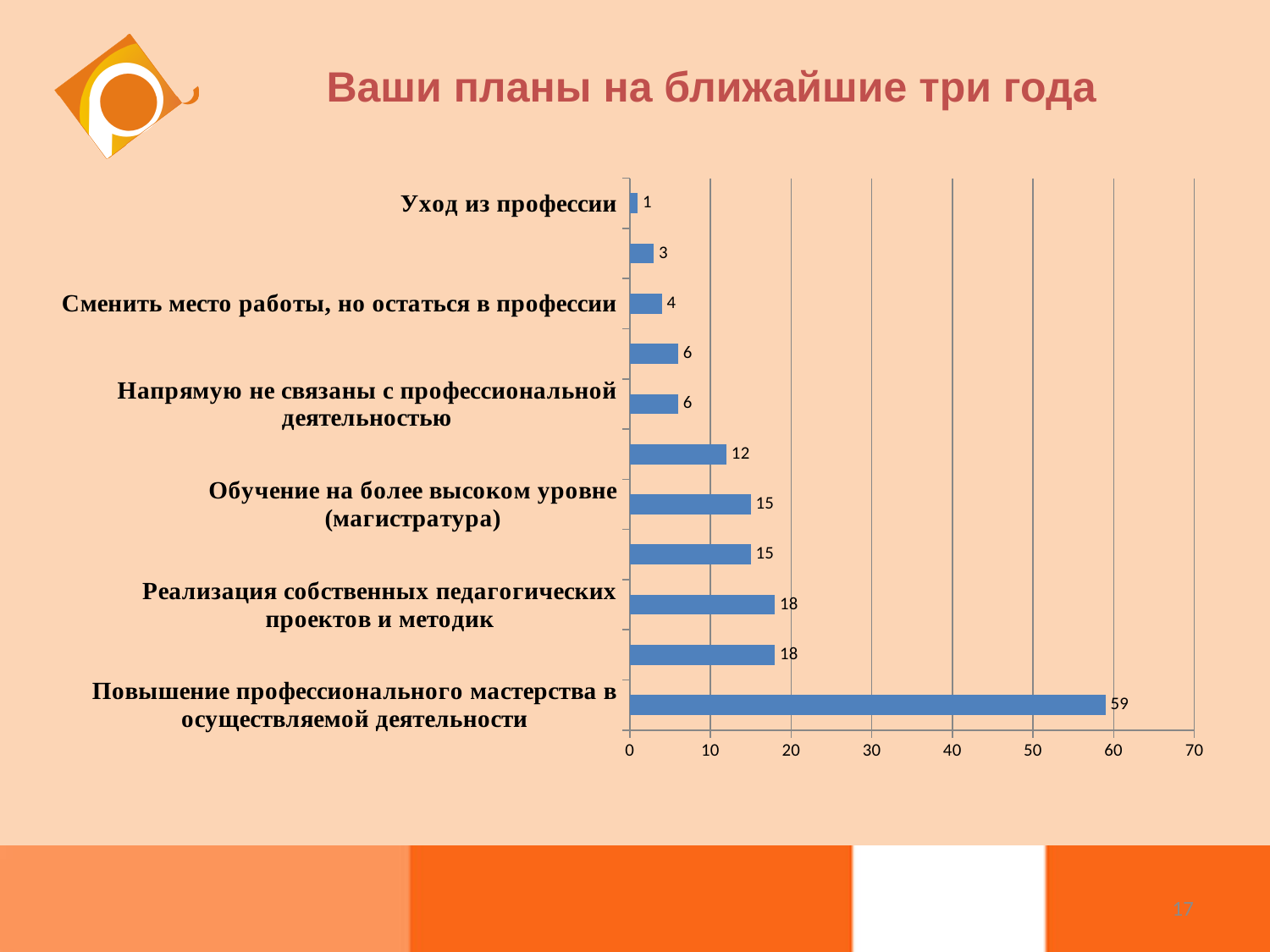
What is the value for "Уход из профессии"? 1 What is the title of the slide? Ваши планы на ближайшие три года What is the value for "Обучение на более высоком уровне (магистратура)"? 15 What is the value for "Сменить место работы, но остаться в профессии"? 4 How many bars are plotted in the chart? 11 Which category has the highest value? Повышение профессионального мастерства в осуществляемой деятельности What is the difference between the values for "Повышение профессионального мастерства в осуществляемой деятельности" and "Реализация собственных педагогических проектов и методик"? 41 Is the value for "Повышение профессионального мастерства в осуществляемой деятельности" greater or less than 50? greater What is the value for "Повышение профессионального мастерства в осуществляемой деятельности"? 59 What kind of chart is shown on the slide? bar chart Which category has the lowest value? Уход из профессии Which is larger: the value for "Напрямую не связаны с профессиональной деятельностью" or for "Сменить место работы, но остаться в профессии"? Напрямую не связаны с профессиональной деятельностью